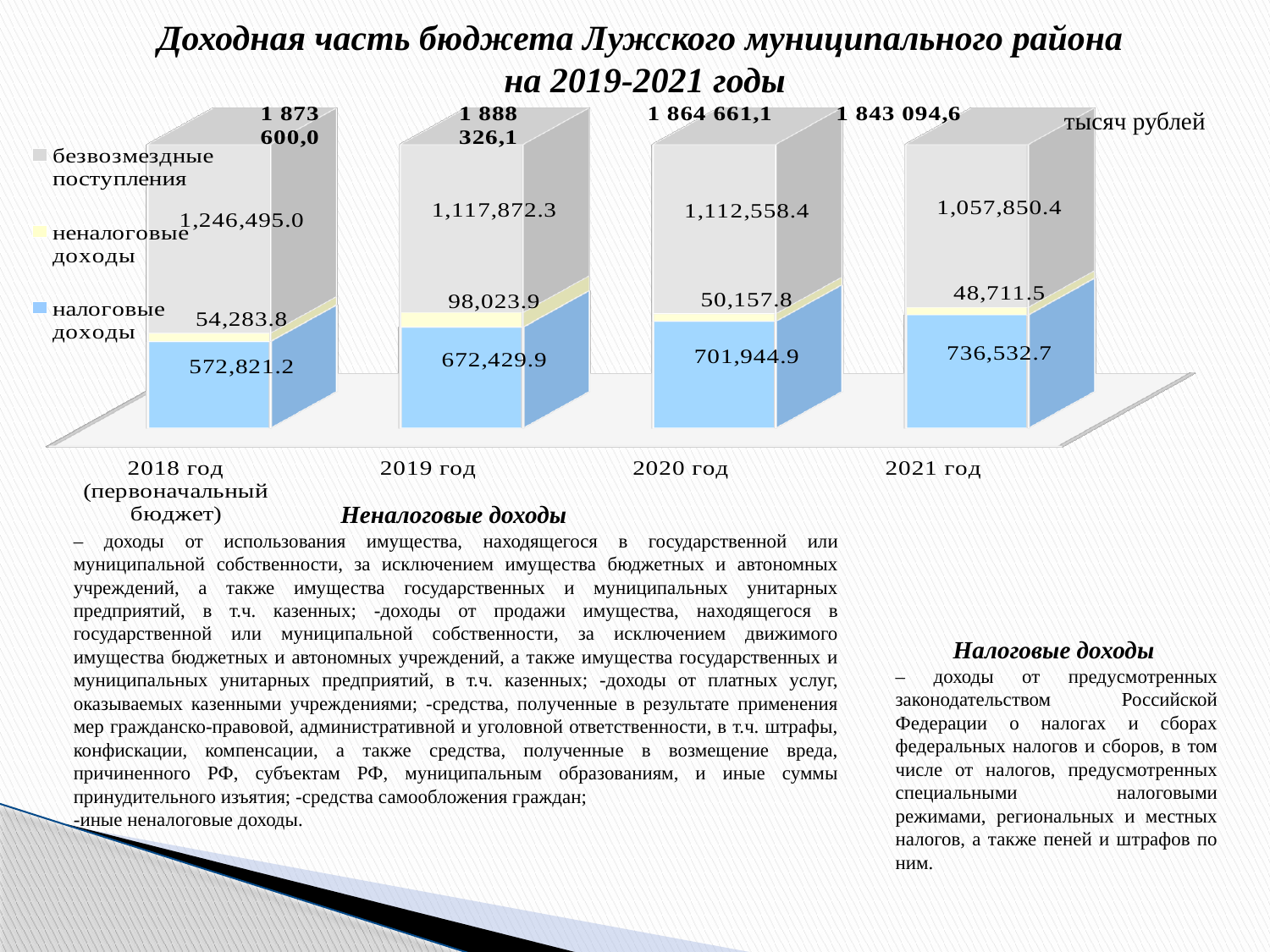
How many series does the legend list? 3 What is the value of неналоговые доходы for 2020 год? 50,157.8 What is the difference between налоговые доходы in 2021 год and in 2018 год? 163,711.5 Which is larger: безвозмездные поступления in 2020 год or in 2021 год? 2020 год What is the value of налоговые доходы for 2021 год? 736,532.7 What type of chart is shown on the slide? stacked bar chart In which year are неналоговые доходы highest? 2019 год What is the value of безвозмездные поступления for 2019 год? 1,117,872.3 Do налоговые доходы rise or fall from 2018 to 2021? rise In which year are налоговые доходы lowest? 2018 год (первоначальный бюджет) How many year categories are shown on the x axis? 4 What is the total of the stacked bar for 2018 год (первоначальный бюджет)? 1 873 600,0